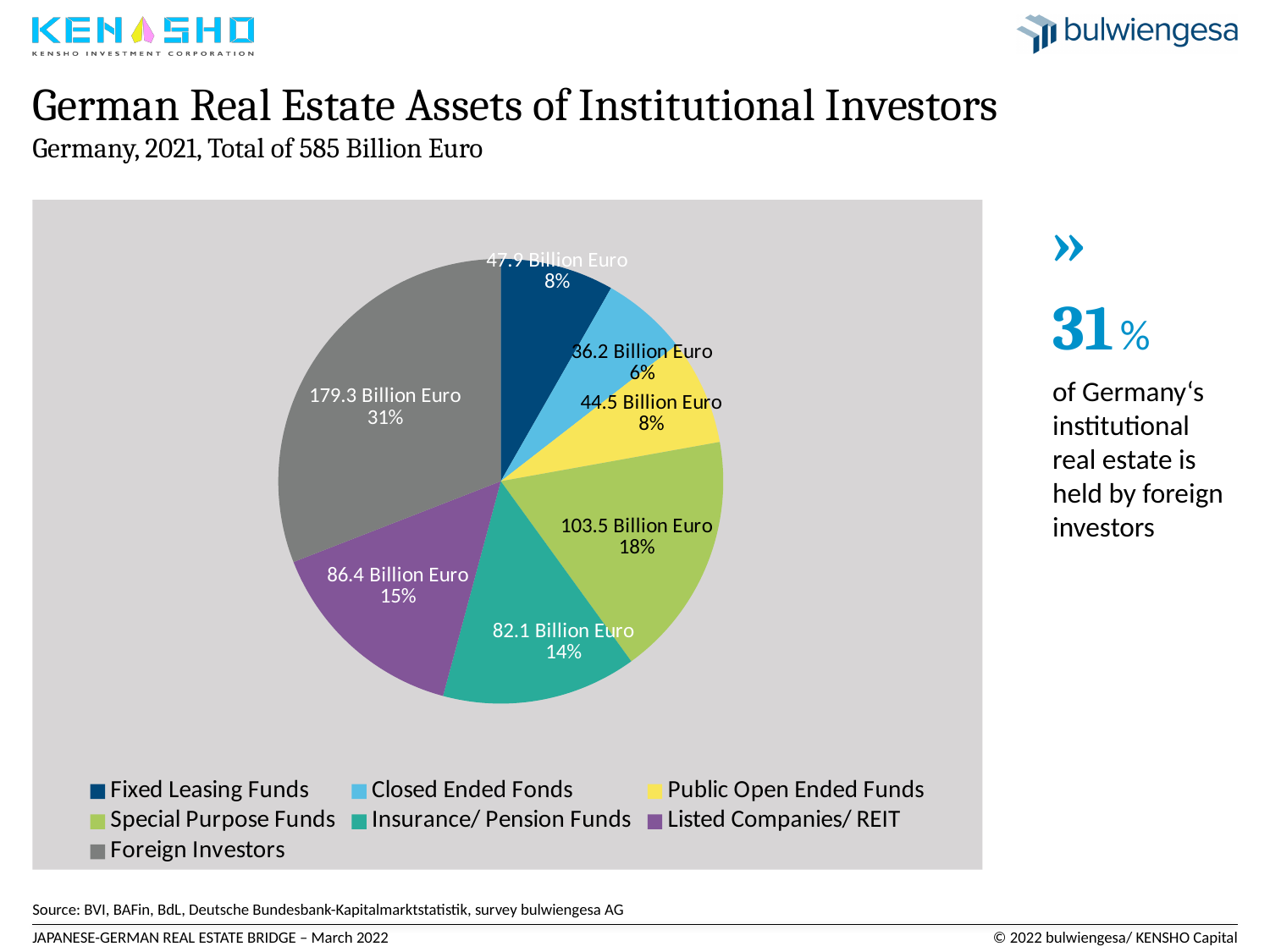
Which category has the smallest slice of the pie? Closed Ended Fonds What share of the pie is held by Special Purpose Funds? 18% What is the value for Closed Ended Fonds? 36.2 Billion Euro What share of the pie do Listed Companies/ REIT hold? 15% How many slices does the pie chart have? 7 What is the value for Insurance/ Pension Funds? 82.1 Billion Euro Which is larger, Listed Companies/ REIT or Insurance/ Pension Funds? Listed Companies/ REIT What is the value for Foreign Investors? 179.3 Billion Euro What is the difference in Billion Euro between Foreign Investors and Special Purpose Funds? 75.8 Billion Euro Which category has the largest slice of the pie? Foreign Investors What is the subtitle of the chart below the main title? Germany, 2021, Total of 585 Billion Euro What kind of chart is shown on the slide? Pie chart